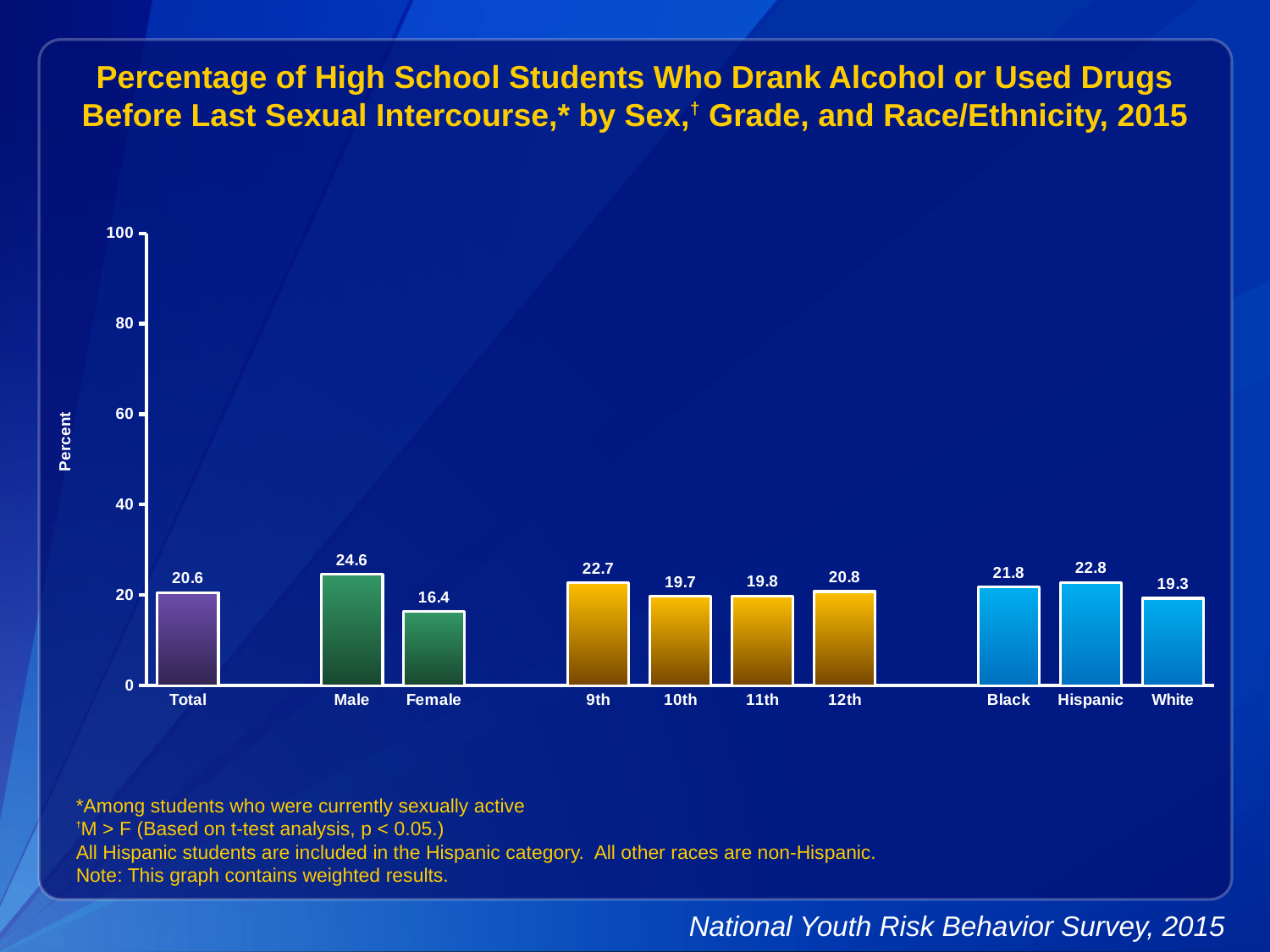
How many categories are shown on the x axis? 10 What is the difference between the Hispanic and White values? 3.5 What is the label of the y axis? Percent Which is larger, the value for 9th or the value for 12th? 9th What kind of chart is this? bar chart What is the difference between the Male and Female values? 8.2 What is the value for Female? 16.4 Is the value for Male greater or less than 20? greater What is the value for Total? 20.6 Which category has the highest value? Male Which category has the lowest value? Female What is the value for Hispanic? 22.8